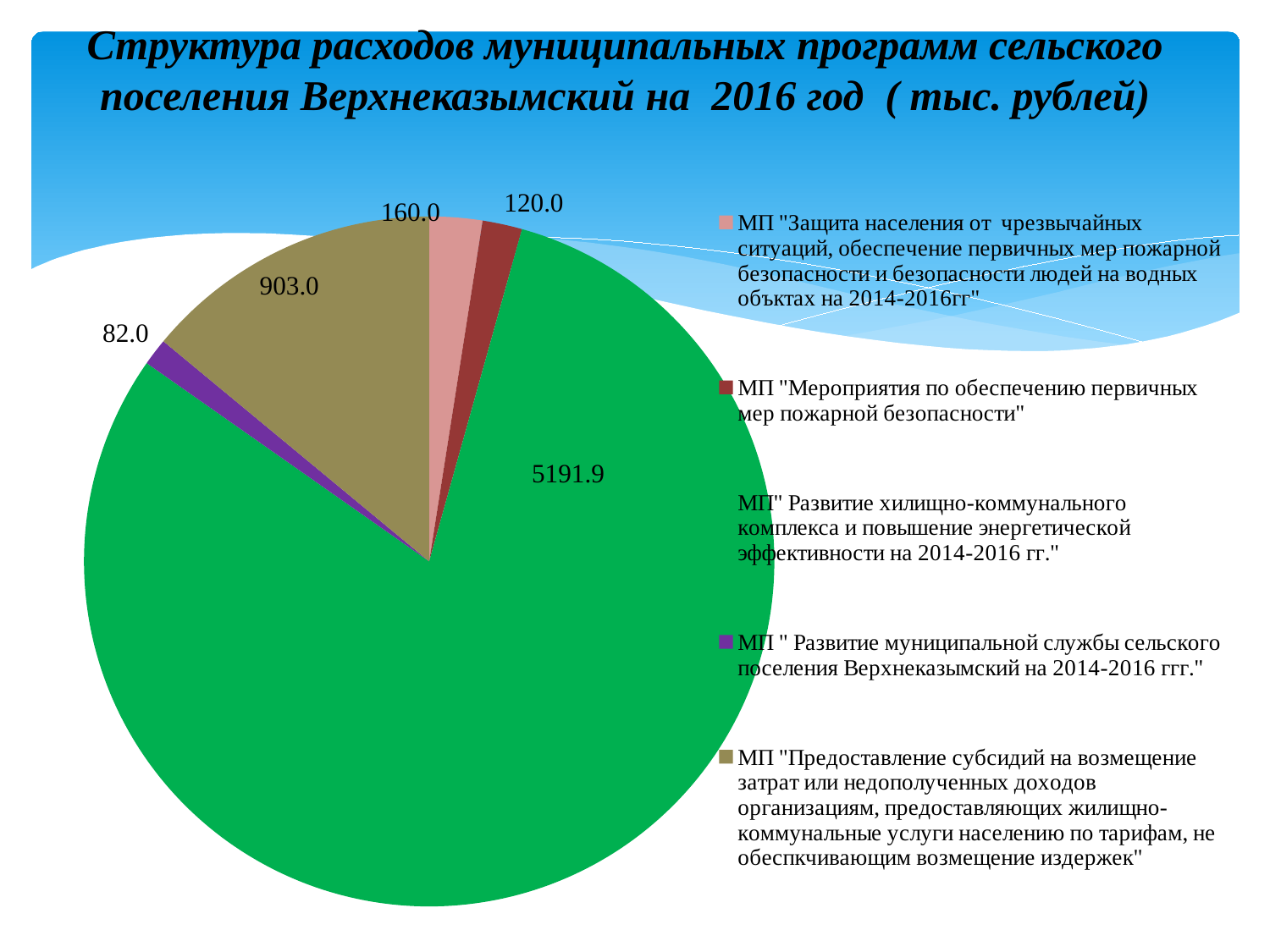
What is the value for МП "Предоставление субсидий на возмещение затрат или недополученных доходов организациям..."? 903.0 What is the value for МП "Развитие жилищно-коммунального комплекса и повышение энергетической эффективности на 2014-2016 гг."? 5191.9 How many slices does the pie chart have? 5 What is the difference between the value for МП "Защита населения от чрезвычайных ситуаций..." and the value for МП "Мероприятия по обеспечению первичных мер пожарной безопасности"? 40.0 How many entries does the legend list? 5 Which program has the smallest share of expenditures? МП "Развитие муниципальной службы сельского поселения Верхнеказымский на 2014-2016 ггг." What is the total of all values shown in the pie chart? 6456.9 What kind of chart is shown on the slide? pie chart Which is larger: the value for МП "Предоставление субсидий..." or the value for МП "Защита населения от чрезвычайных ситуаций..."? МП "Предоставление субсидий..." Which program has the largest share of expenditures? МП "Развитие жилищно-коммунального комплекса и повышение энергетической эффективности на 2014-2016 гг." What is the value for МП "Мероприятия по обеспечению первичных мер пожарной безопасности"? 120.0 What is the value for МП "Развитие муниципальной службы сельского поселения Верхнеказымский на 2014-2016 ггг."? 82.0